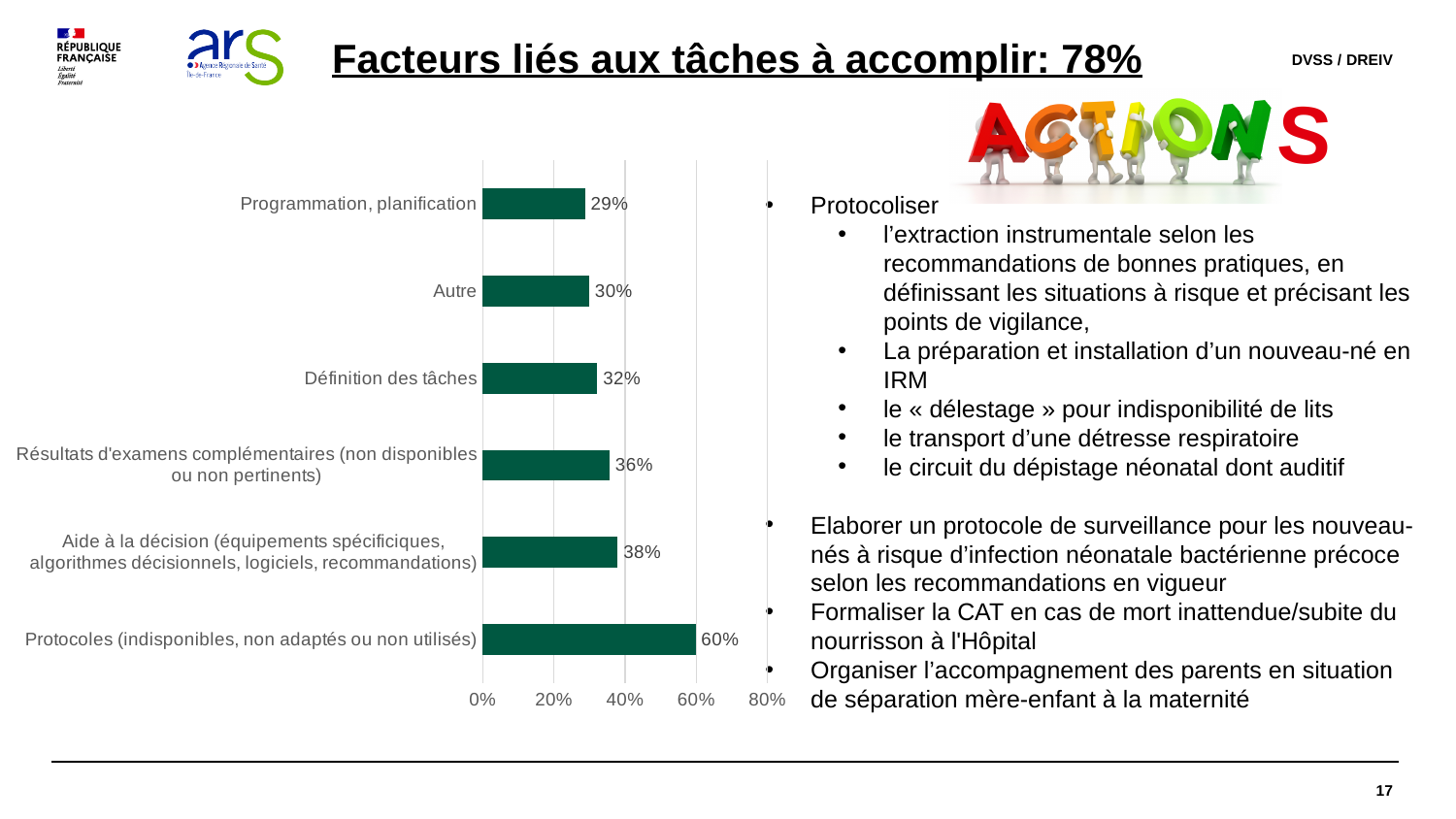
What kind of chart is shown on the slide? Bar chart Which category has the lowest value? Programmation, planification What is the maximum value shown on the chart's horizontal axis? 80% What is the value for "Définition des tâches"? 32% What is the value for "Aide à la décision (équipements spécifiques, algorithmes décisionnels, logiciels, recommandations)"? 38% How many categories are shown in the chart? 6 Is the value for "Protocoles (indisponibles, non adaptés ou non utilisés)" greater or less than 40%? greater Which is larger: the value for "Résultats d'examens complémentaires" or the value for "Autre"? Résultats d'examens complémentaires What is the value for "Programmation, planification"? 29% Which category has the highest value? Protocoles (indisponibles, non adaptés ou non utilisés) What is the value for "Protocoles (indisponibles, non adaptés ou non utilisés)"? 60% What is the difference between the values for "Protocoles (indisponibles, non adaptés ou non utilisés)" and "Aide à la décision"? 22%